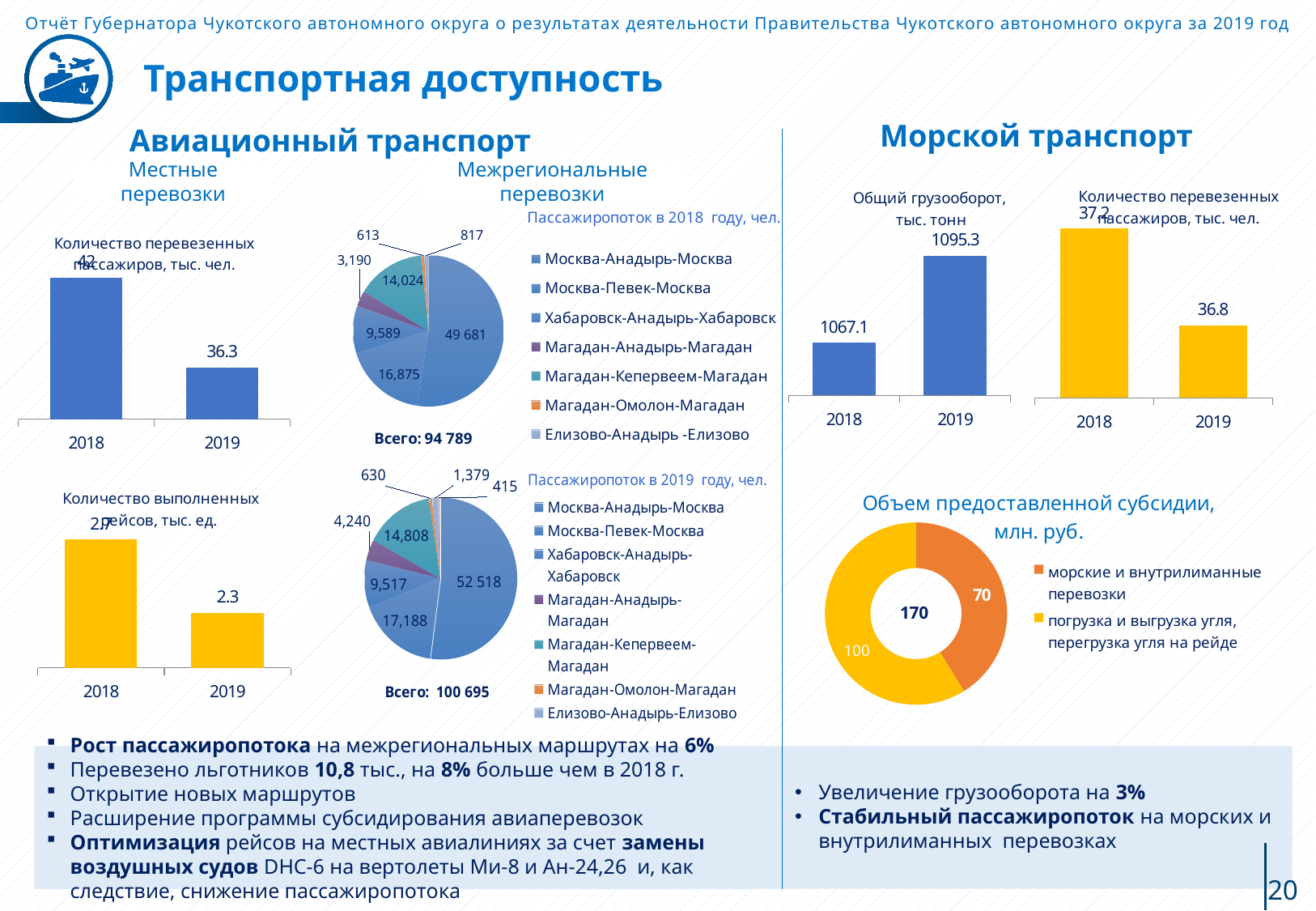
In the chart 'Количество выполненных рейсов, тыс. ед.', what is the difference between the 2018 and 2019 values? 0.4 In the chart 'Количество перевезенных пассажиров, тыс. чел.' under Морской транспорт, which year has the larger value, 2018 or 2019? 2018 In the chart 'Объем предоставленной субсидии, млн. руб.', what is the value for 'погрузка и выгрузка угля, перегрузка угля на рейде'? 100 In the chart 'Количество перевезенных пассажиров, тыс. чел.' under Местные перевозки, what is the value for 2019? 36.3 In the chart 'Общий грузооборот, тыс. тонн', what is the value for 2019? 1095.3 In the chart 'Количество выполненных рейсов, тыс. ед.', what is the value for 2018? 2.7 In the chart 'Количество перевезенных пассажиров, тыс. чел.' under Местные перевозки, do the values rise or fall from 2018 to 2019? fall In the pie chart 'Пассажиропоток в 2018 году, чел.', what is the total shown? 94 789 What kind of chart is 'Общий грузооборот, тыс. тонн'? bar chart How many entries does the legend of the pie chart 'Пассажиропоток в 2019 году, чел.' list? 7 In the chart 'Общий грузооборот, тыс. тонн', by how much does the 2019 value exceed the 2018 value? 28.2 In the pie chart 'Пассажиропоток в 2019 году, чел.', what is the value of the largest slice? 52 518